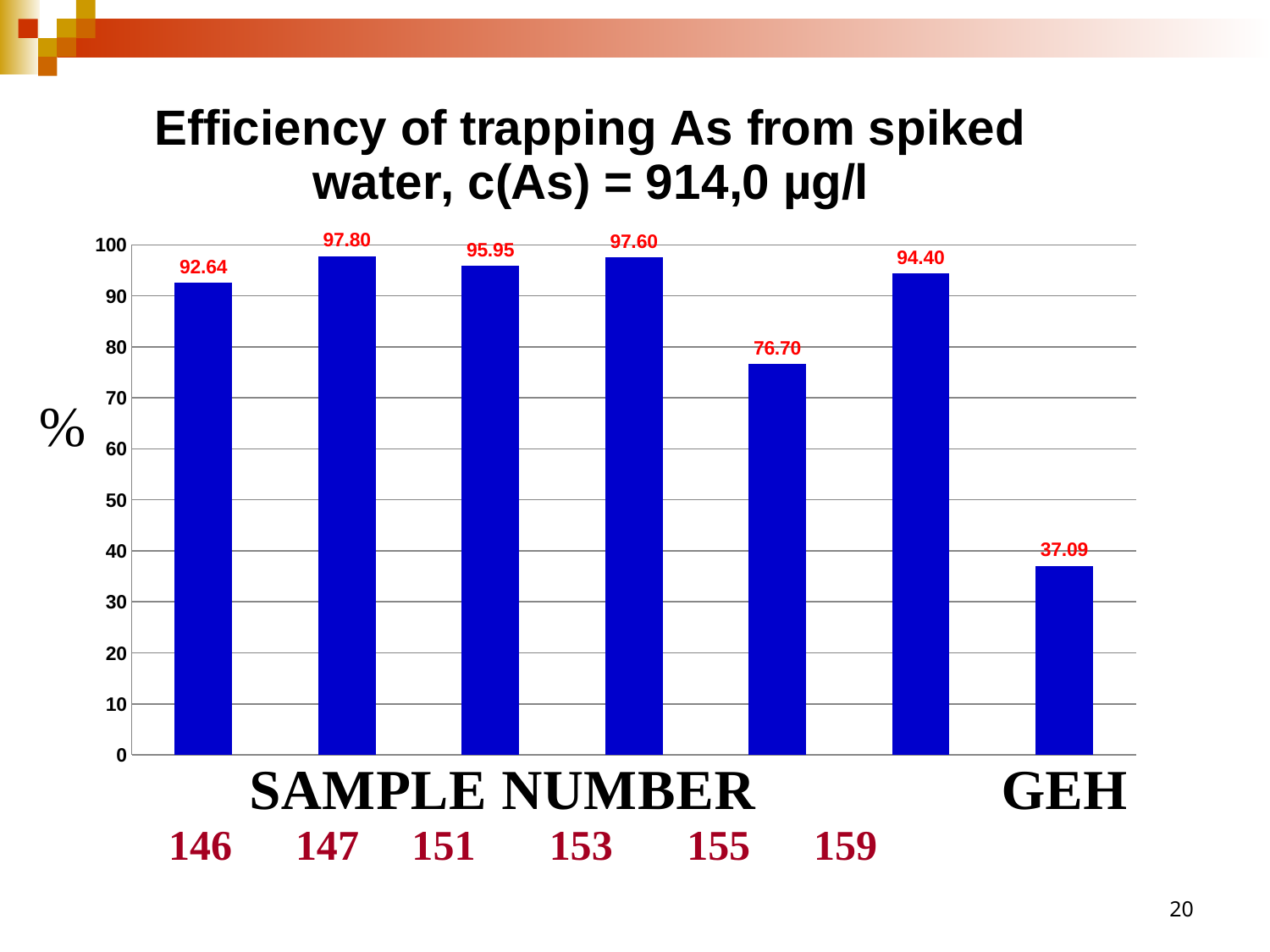
What is the difference in trapping efficiency between sample 159 and GEH? 57.31 Which bar shows the lowest trapping efficiency? GEH What is the difference in trapping efficiency between sample 147 and sample 155? 21.10 What is the trapping efficiency for GEH? 37.09 Which has a higher trapping efficiency, sample 151 or sample 159? 151 What type of chart is shown on the slide? bar chart What is the As concentration of the spiked water given in the chart title? 914,0 µg/l What is the trapping efficiency for sample 146? 92.64 How many bars are shown in the chart? 7 What is the trapping efficiency for sample 155? 76.70 Which sample has the highest trapping efficiency? 147 Is the value for sample 155 greater or less than 80? less